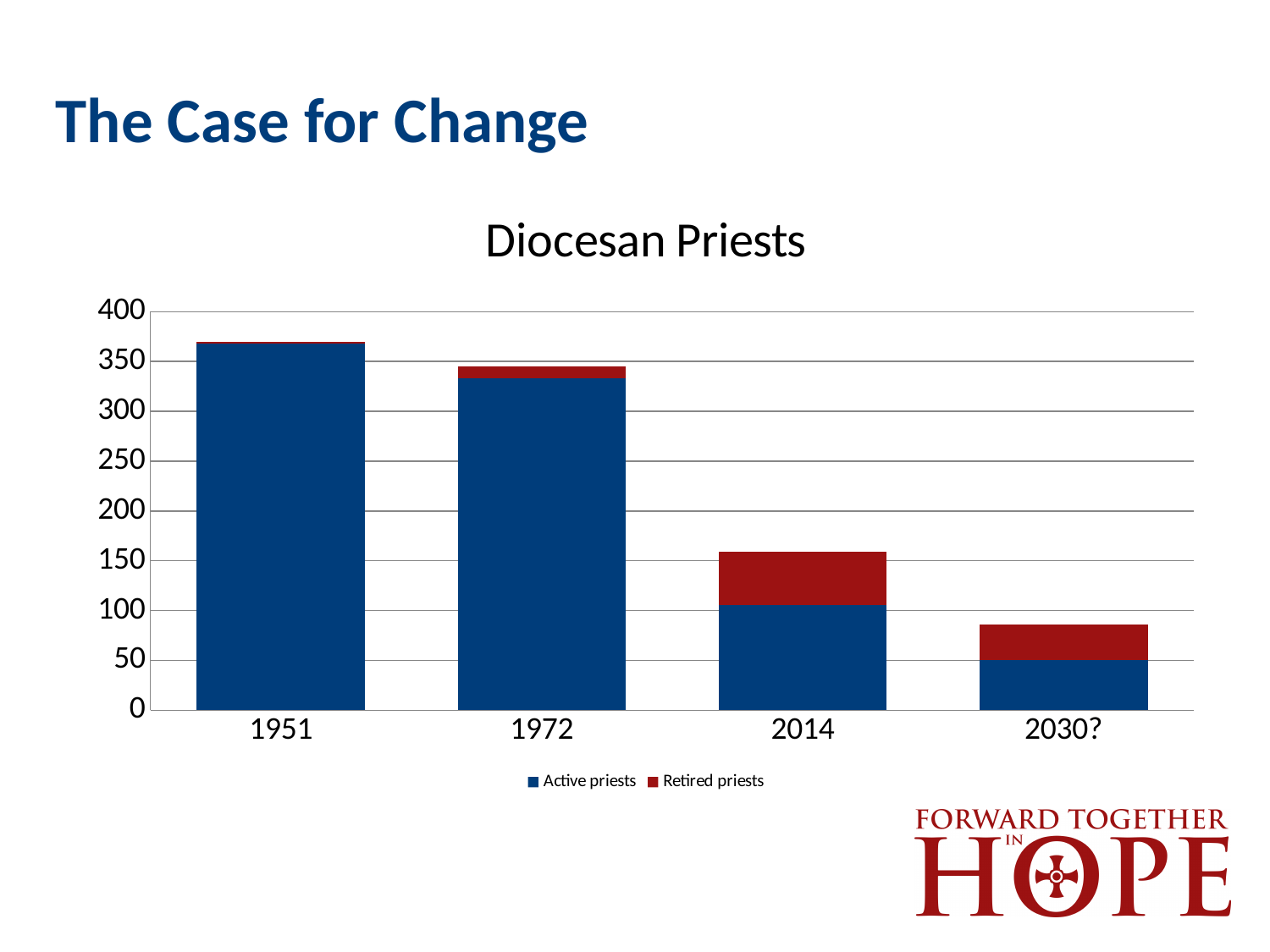
How many categories are shown on the x axis? 4 What is the title of the chart? Diocesan Priests Which year has the tallest total bar? 1951 Is the total bar for 2030? greater or less than 100? less What kind of chart is shown on the slide? Stacked bar chart Which category has the shortest total bar? 2030? Which is larger, the Active priests value for 1972 or for 2014? 1972 How many series does the legend list? 2 Is the total bar for 1951 greater or less than 350? greater Do the total bar heights rise or fall from 1951 to 2030?? fall Which year has the largest Retired priests segment? 2014 Is the Active priests value for 2014 greater or less than 150? less